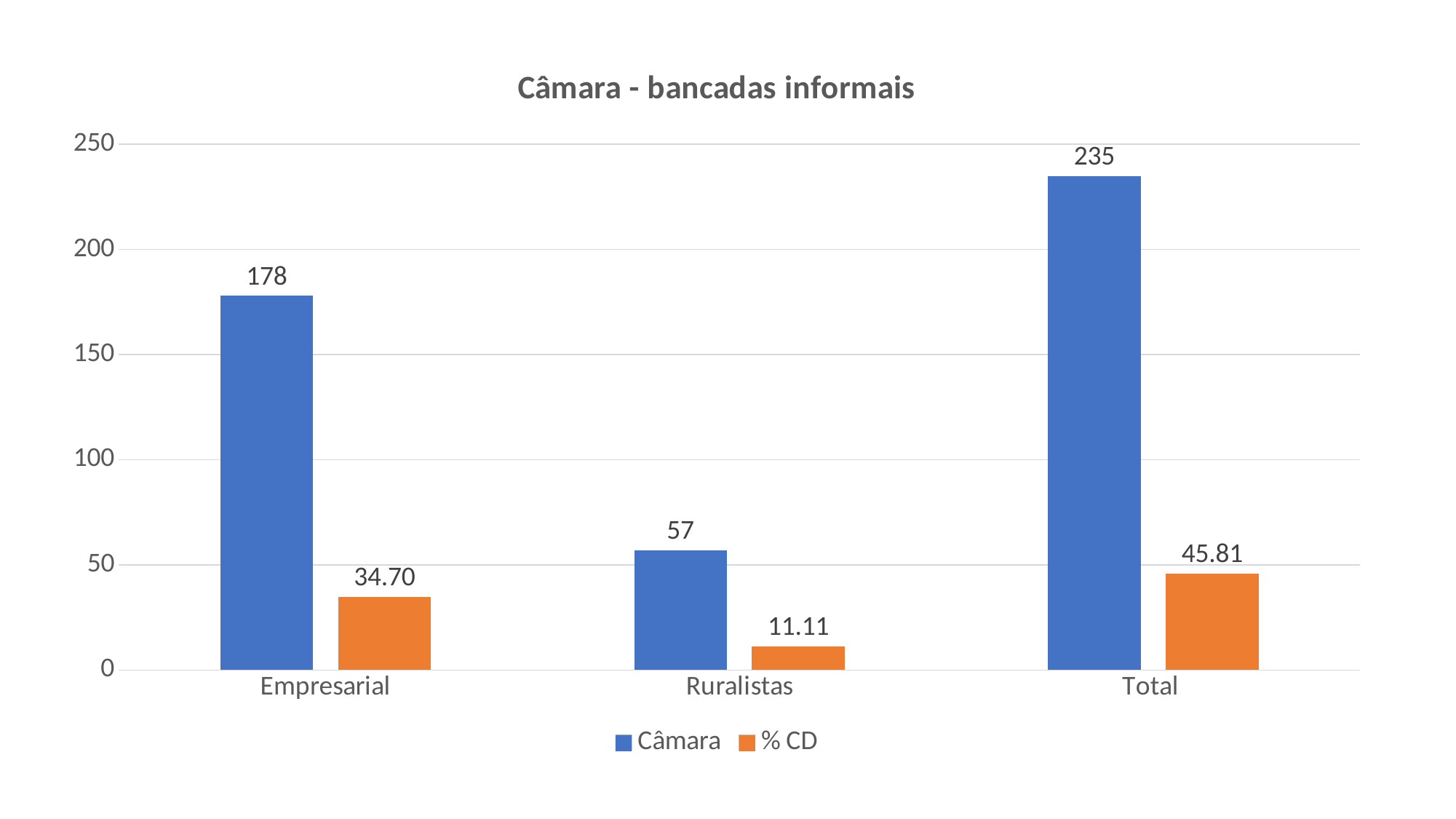
How many categories are shown on the x axis? 3 What is the Câmara value for Ruralistas? 57 What type of chart is shown? bar chart What is the Câmara value for Empresarial? 178 What is the difference between the Câmara values for Empresarial and Ruralistas? 121 What is the % CD value for Total? 45.81 Which category has the lowest % CD value? Ruralistas Which category has the highest Câmara value? Total Which is larger, the % CD value for Empresarial or for Total? Total What is the % CD value for Ruralistas? 11.11 Is the Câmara value for Ruralistas greater or less than 100? less How many series does the legend list? 2